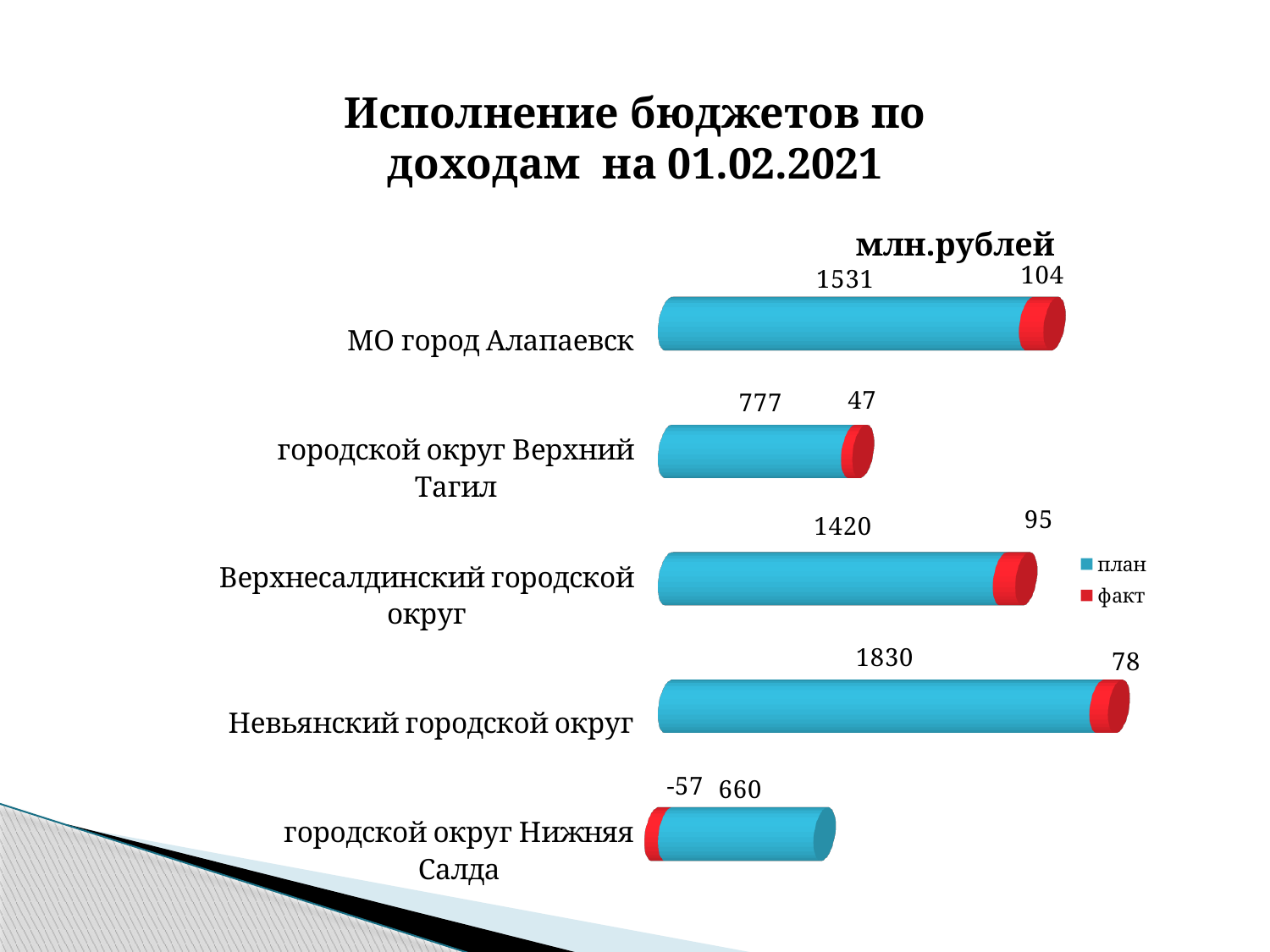
Which category has the highest план value? Невьянский городской округ How many series does the legend list? 2 Which category has the lowest факт value? городской округ Нижняя Салда What is the difference between the план and факт values for Верхнесалдинский городской округ? 1325 What unit is stated above the chart? млн.рублей What is the факт value for городской округ Нижняя Салда? -57 What is the план value for Невьянский городской округ? 1830 Which is larger, the факт value for МО город Алапаевск or the факт value for Невьянский городской округ? МО город Алапаевск What is the факт value for МО город Алапаевск? 104 What kind of chart is shown on the slide? bar chart What is the план value for городской округ Верхний Тагил? 777 How many categories are shown in the chart? 5